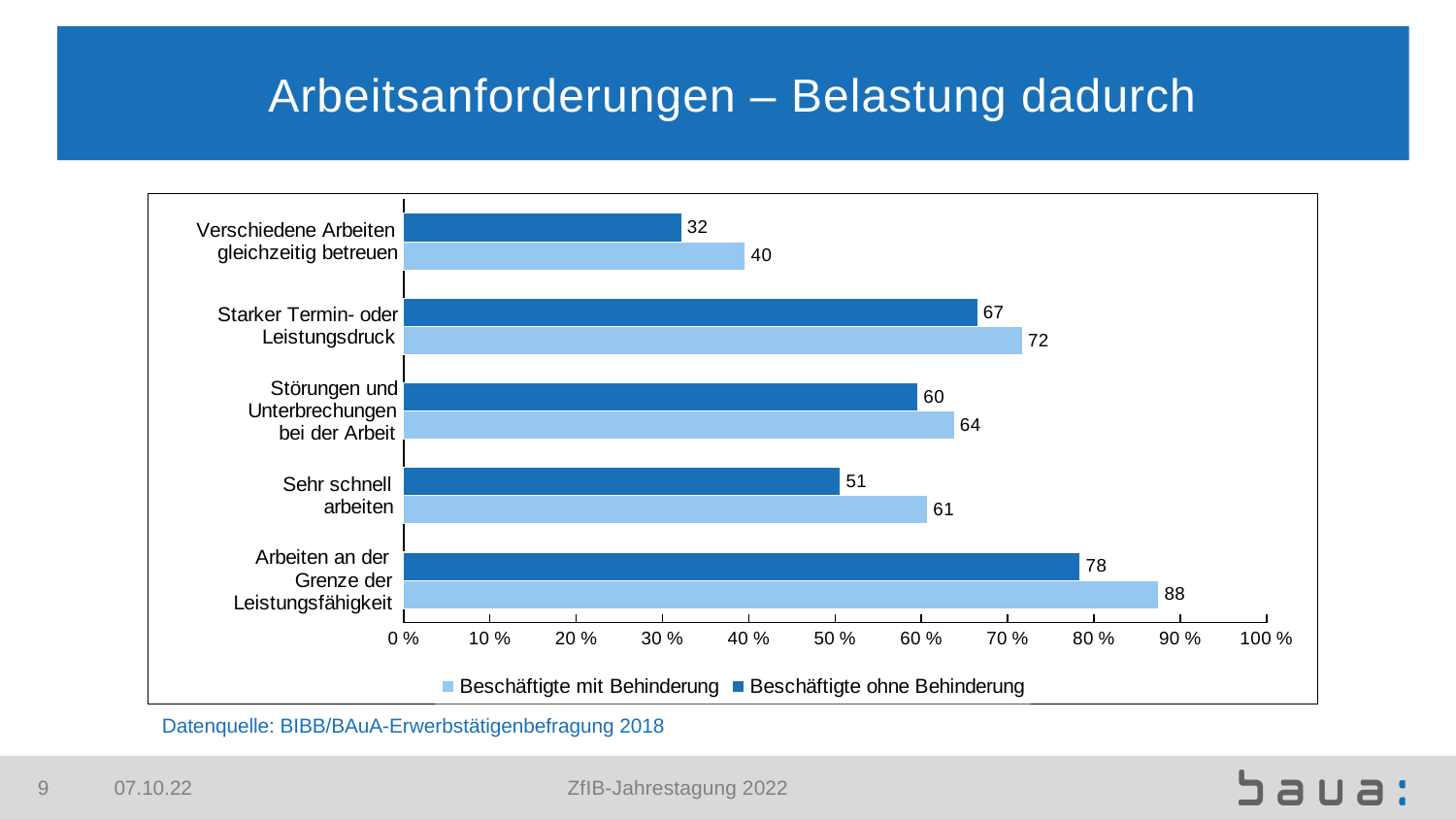
What is the difference between 'Beschäftigte mit Behinderung' and 'Beschäftigte ohne Behinderung' for 'Starker Termin- oder Leistungsdruck'? 5 What is the value for 'Beschäftigte mit Behinderung' for 'Sehr schnell arbeiten'? 61 What is the value for 'Beschäftigte mit Behinderung' for 'Arbeiten an der Grenze der Leistungsfähigkeit'? 88 Which category has the highest value for 'Beschäftigte ohne Behinderung'? Arbeiten an der Grenze der Leistungsfähigkeit What is the difference between 'Beschäftigte mit Behinderung' and 'Beschäftigte ohne Behinderung' for 'Sehr schnell arbeiten'? 10 Which category has the lowest value for 'Beschäftigte mit Behinderung'? Verschiedene Arbeiten gleichzeitig betreuen How many categories are shown on the chart? 5 For 'Störungen und Unterbrechungen bei der Arbeit', which series has the larger value? Beschäftigte mit Behinderung What kind of chart is shown on the slide? bar chart How many series does the legend list? 2 What is the value for 'Beschäftigte ohne Behinderung' for 'Verschiedene Arbeiten gleichzeitig betreuen'? 32 Is the value for 'Beschäftigte ohne Behinderung' for 'Starker Termin- oder Leistungsdruck' greater or less than 60 %? greater